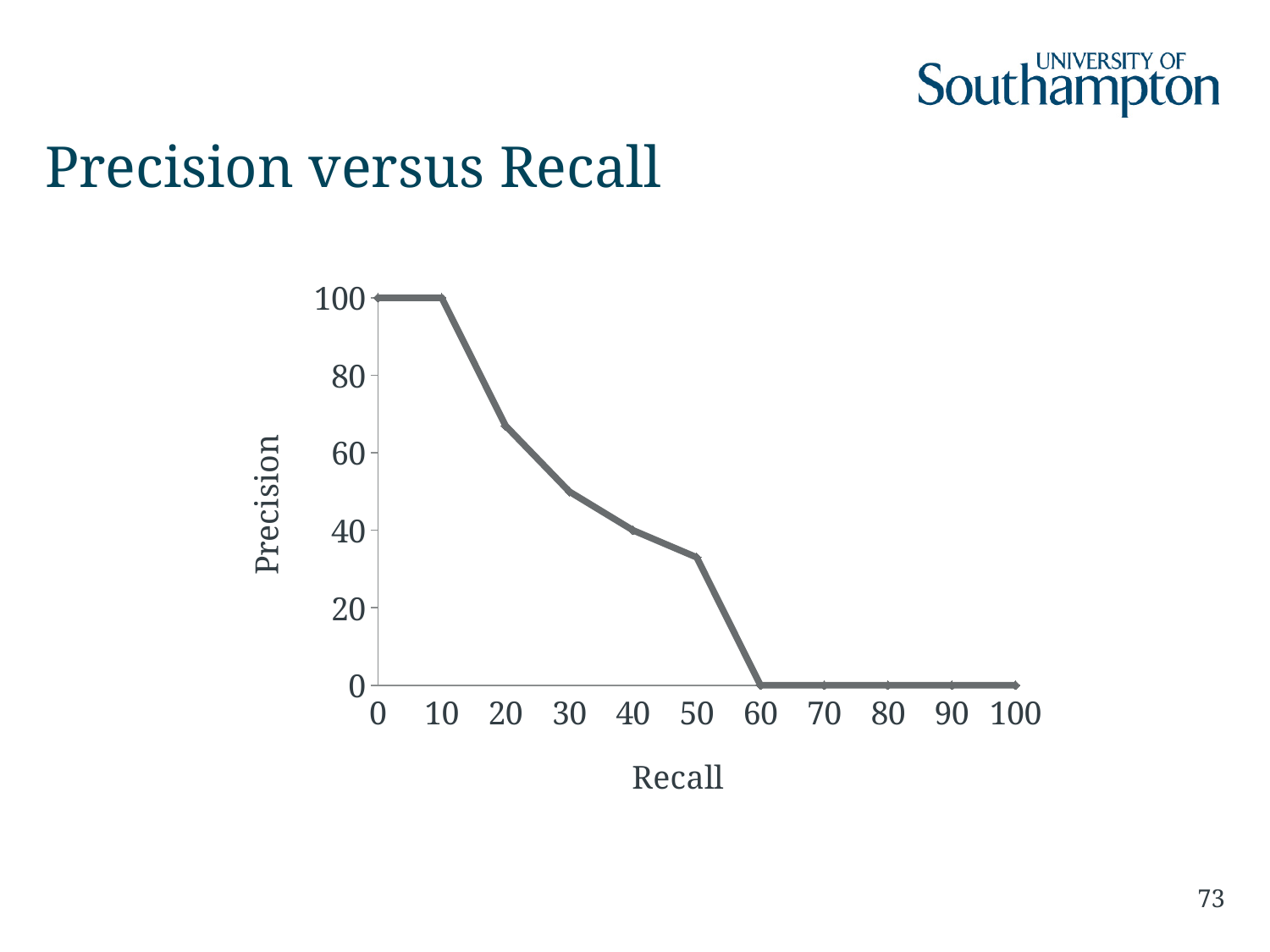
Is the precision value at recall 50 greater or less than 40? less How many data points are plotted on the line? 11 What is the precision value when recall is 60? 0 What kind of chart is shown on the slide? line chart What is the precision value when recall is 40? 40 Which is larger, the precision at recall 20 or the precision at recall 50? recall 20 What is the label on the x axis? Recall Is the precision value at recall 20 greater or less than 60? greater What is the precision value when recall is 10? 100 Is the precision value at recall 30 greater or less than 60? less What is the precision value when recall is 100? 0 Does precision rise or fall as recall increases along the x axis? fall